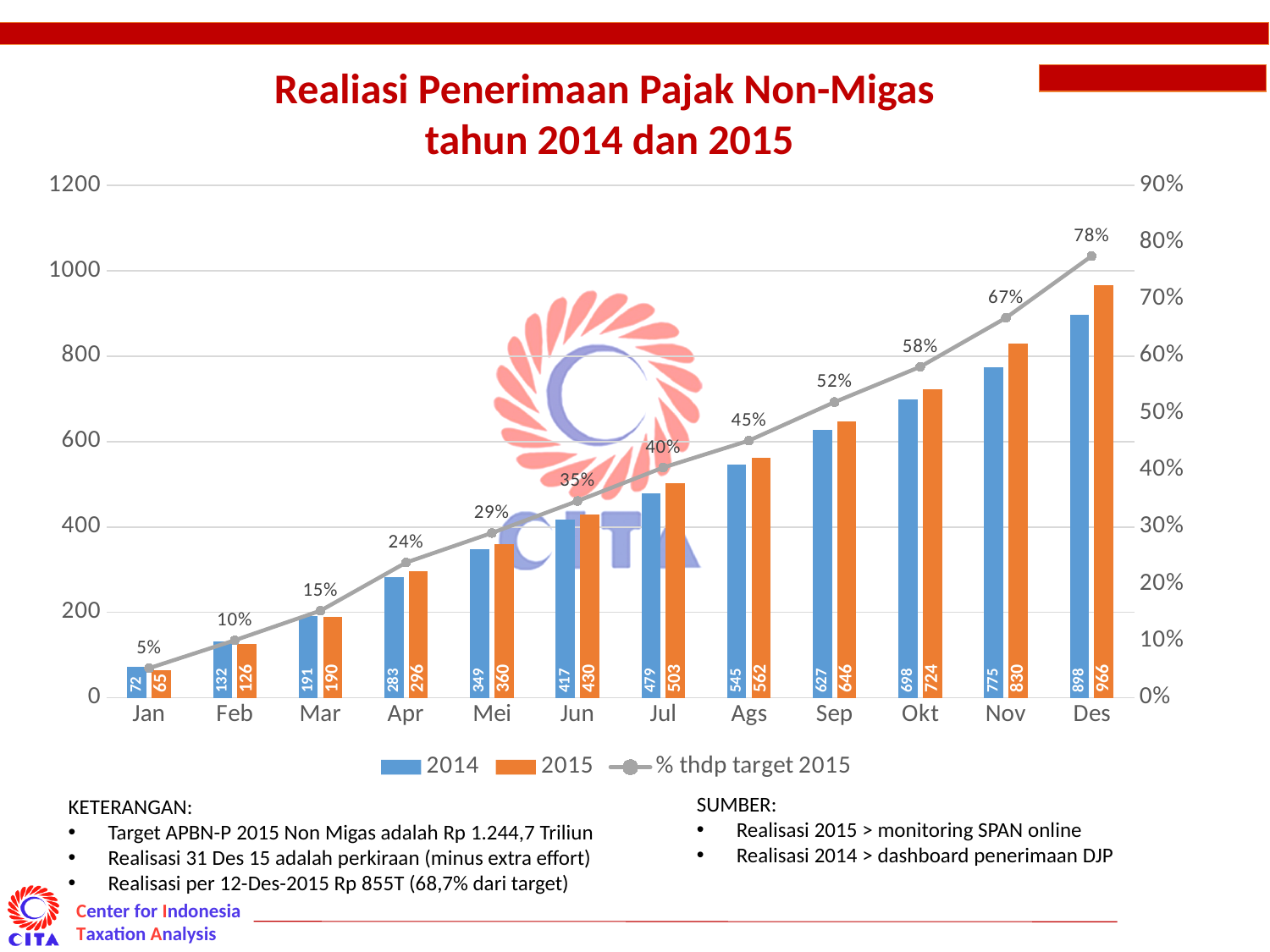
What is the value for 2014 in Jun? 417 Does the % thdp target 2015 line rise or fall from Jan to Des? rise What kind of chart is used for the 2014 and 2015 series? bar chart What is the title of the chart? Realiasi Penerimaan Pajak Non-Migas tahun 2014 dan 2015 What is the % thdp target 2015 value in Sep? 52% What is the value for 2015 in Des? 966 How many series does the legend list? 3 How many months are shown on the x axis? 12 What is the difference between the 2015 and 2014 values in Nov? 55 Which is larger in Feb, the 2014 value or the 2015 value? 2014 Which month has the highest value for 2015? Des Which month has the lowest value for 2014? Jan